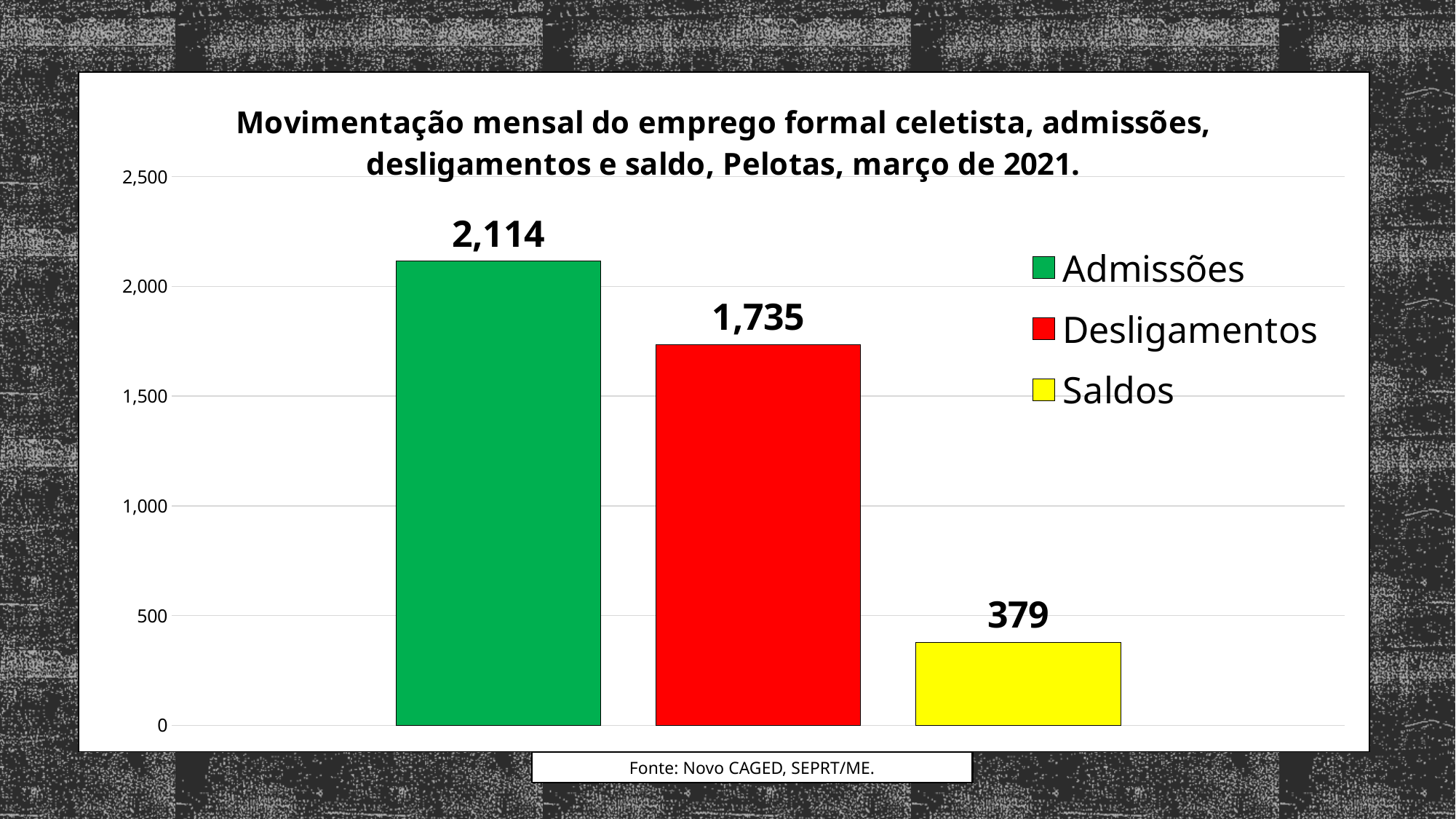
Which series has the highest value? Admissões How many series does the legend list? 3 What is the value for Admissões? 2,114 What is the difference between Desligamentos and Saldos? 1,356 Is the value for Saldos greater or less than 500? less What colour is the bar for Desligamentos? red What is the value for Desligamentos? 1,735 What is the difference between Admissões and Desligamentos? 379 What kind of chart is shown on the slide? bar chart Which is larger, Admissões or Desligamentos? Admissões What is the value for Saldos? 379 Which series has the lowest value? Saldos